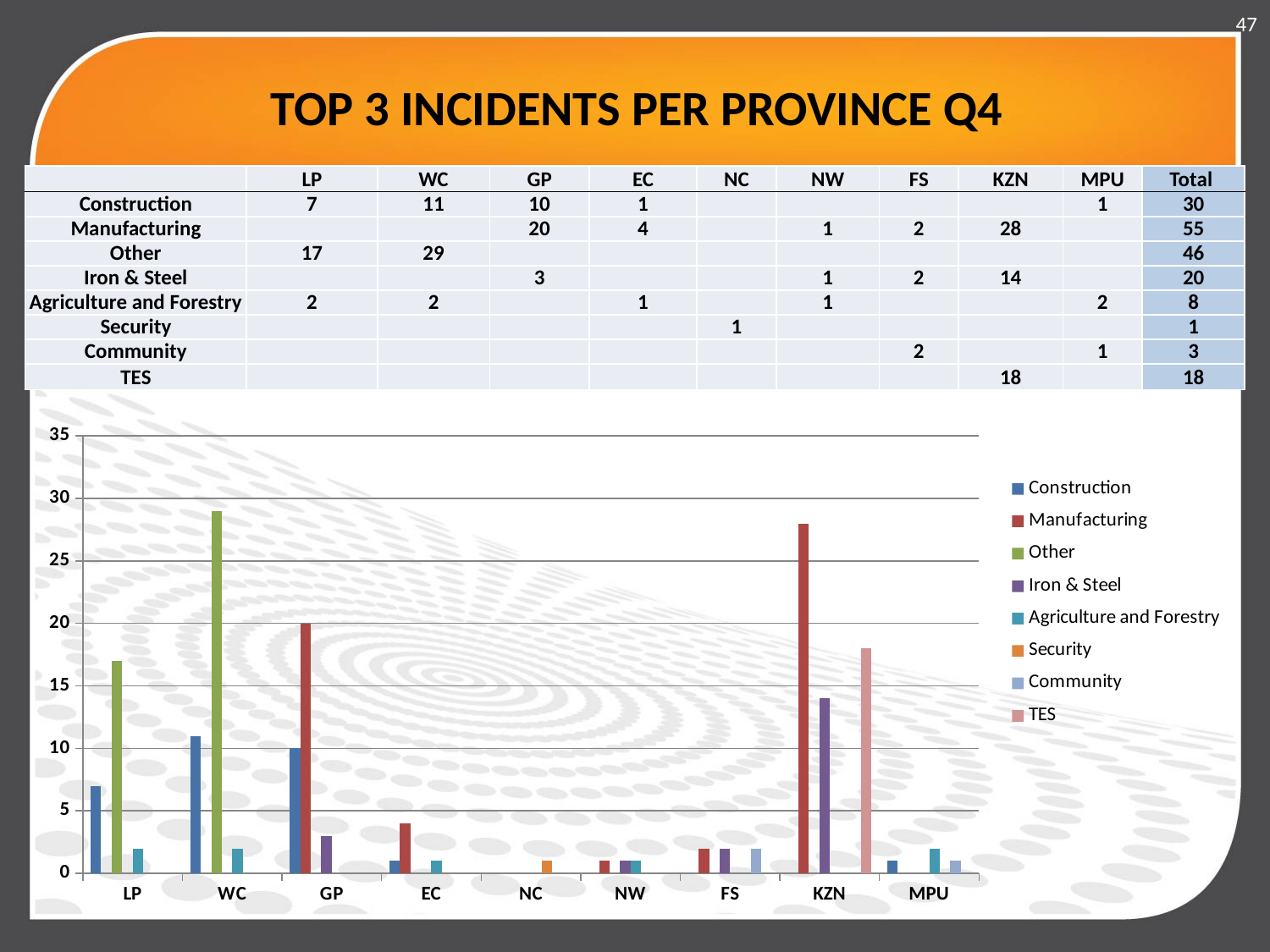
What kind of chart is shown on the slide? bar chart Which is larger, the Manufacturing value for GP or the Construction value for GP? Manufacturing value for GP What is the TES value for KZN? 18 What is the Other value for WC? 29 How many provinces are shown on the x axis of the chart? 9 Is the Manufacturing value for KZN greater or less than 25? greater What is the difference between the Other value for WC and the Other value for LP? 12 What is the title of the slide containing the chart? TOP 3 INCIDENTS PER PROVINCE Q4 Which province has the highest Manufacturing value? KZN What is the Manufacturing value for KZN? 28 How many series does the chart legend list? 8 Which province has the highest Construction value? WC